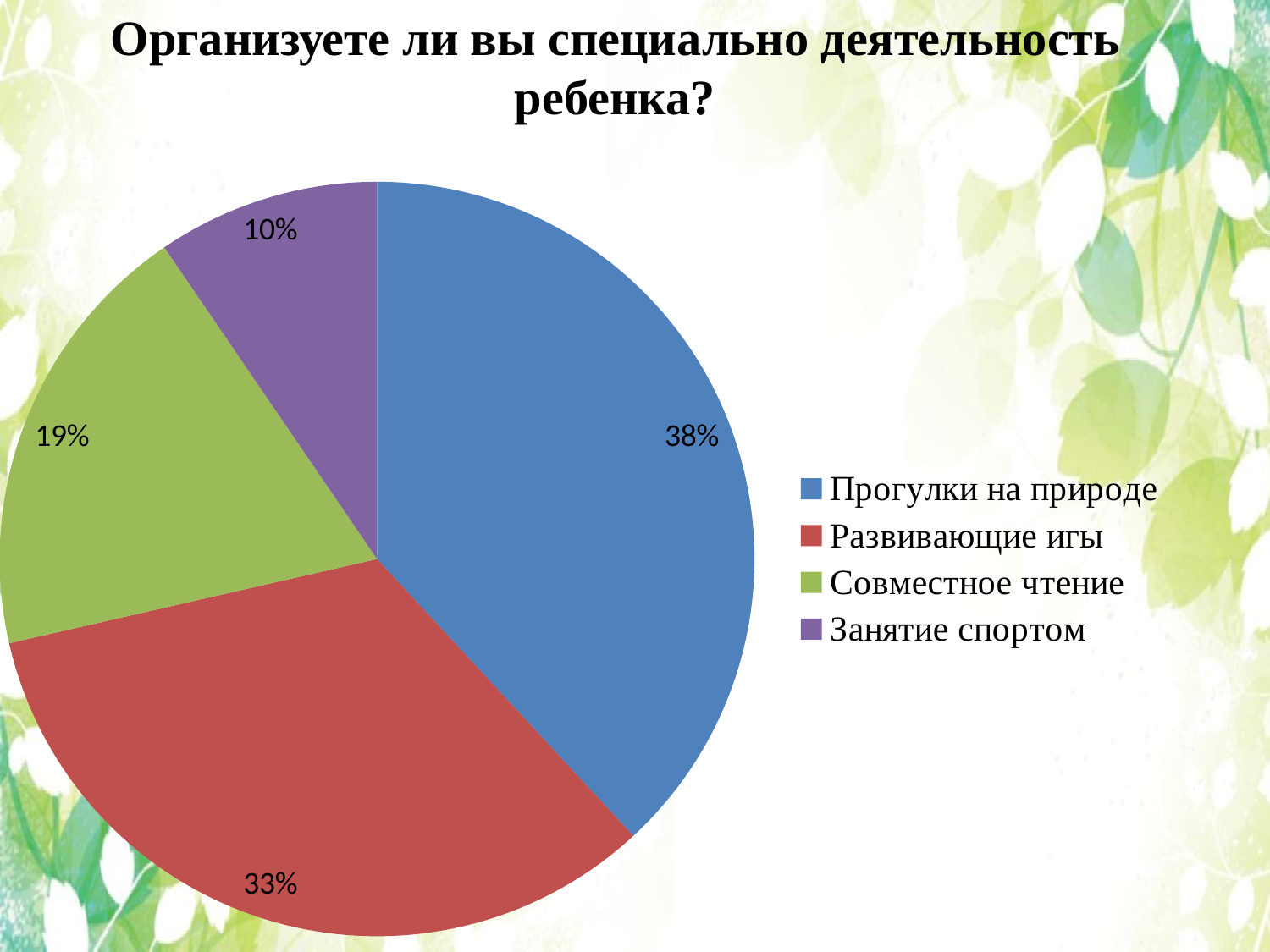
What share of the pie does "Совместное чтение" have? 19% What is the difference in percentage points between "Развивающие игы" and "Совместное чтение"? 14 What colour is the slice for "Совместное чтение"? green What share of the pie does "Развивающие игы" have? 33% Which category has the largest slice of the pie? Прогулки на природе What share of the pie does "Занятие спортом" have? 10% What kind of chart is shown on the slide? pie chart What is the difference in percentage points between "Прогулки на природе" and "Занятие спортом"? 28 Which is larger, the slice for "Совместное чтение" or the slice for "Занятие спортом"? Совместное чтение Which category has the smallest slice of the pie? Занятие спортом How many slices does the pie chart have? 4